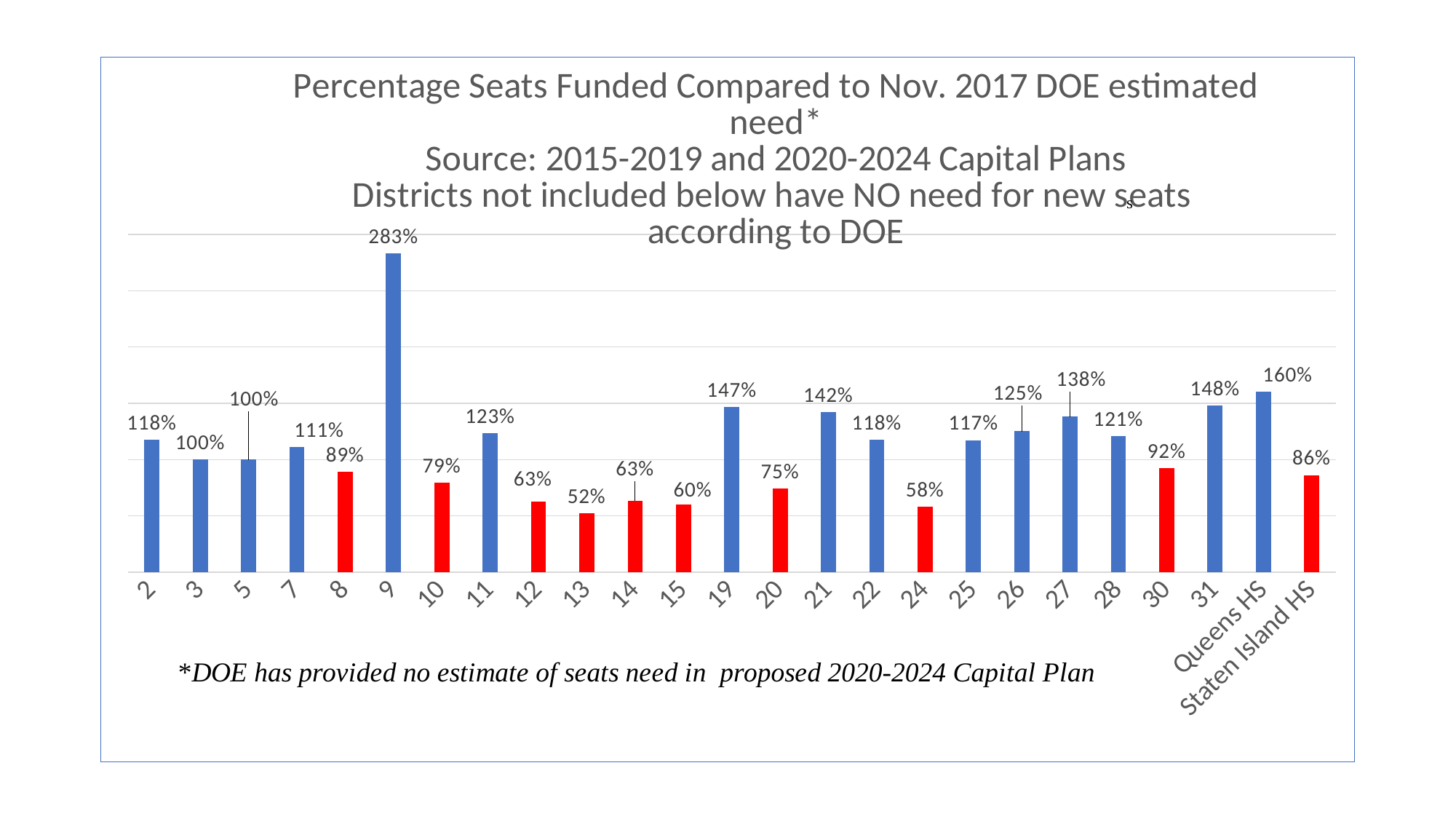
What is the value for Queens HS? 160% What is the difference between the values for Queens HS and Staten Island HS? 74% Which category has the highest value? 9 Which category has the lowest value? 13 What is the value for district 9? 283% How many categories are shown on the x axis? 25 Which is larger, the value for district 19 or the value for district 21? 19 What is the value for district 13? 52% How many bars are coloured red? 10 What is the value for Staten Island HS? 86% What kind of chart is this? bar chart What is the difference between the values for district 31 and district 30? 56%